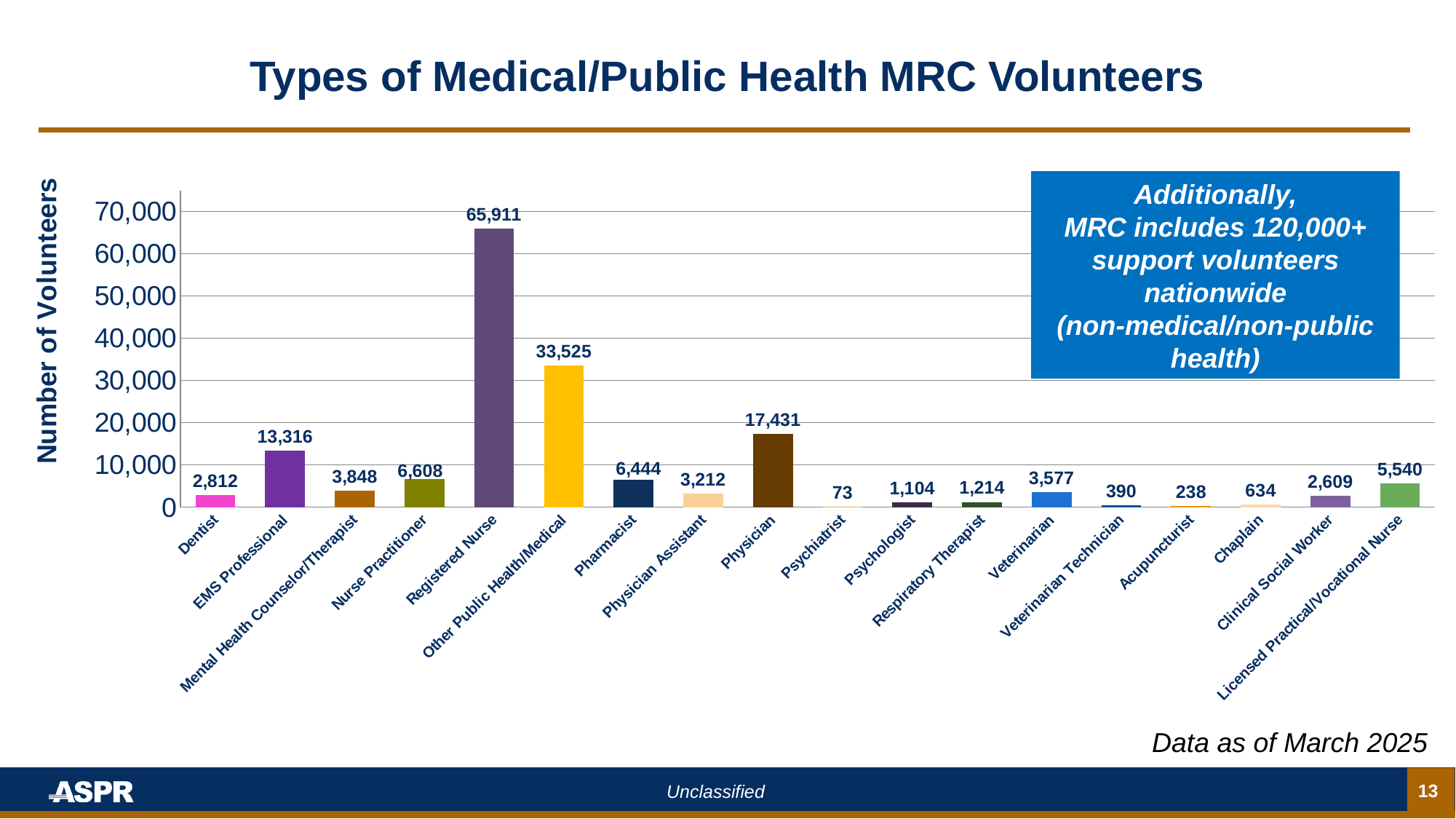
What is the difference between the Physician and EMS Professional values? 4,115 What is the difference between the Registered Nurse and Other Public Health/Medical values? 32,386 Which category has the highest number of volunteers? Registered Nurse What is the label of the y axis? Number of Volunteers What is the number of Physician volunteers? 17,431 Which is larger, the value for Pharmacist or the value for Licensed Practical/Vocational Nurse? Pharmacist What kind of chart is shown on the slide? bar chart How many categories are shown on the x axis? 18 Which category has the lowest number of volunteers? Psychiatrist What is the value for Veterinarian? 3,577 How many volunteers are Registered Nurses? 65,911 Is the value for Other Public Health/Medical greater or less than 30,000? greater